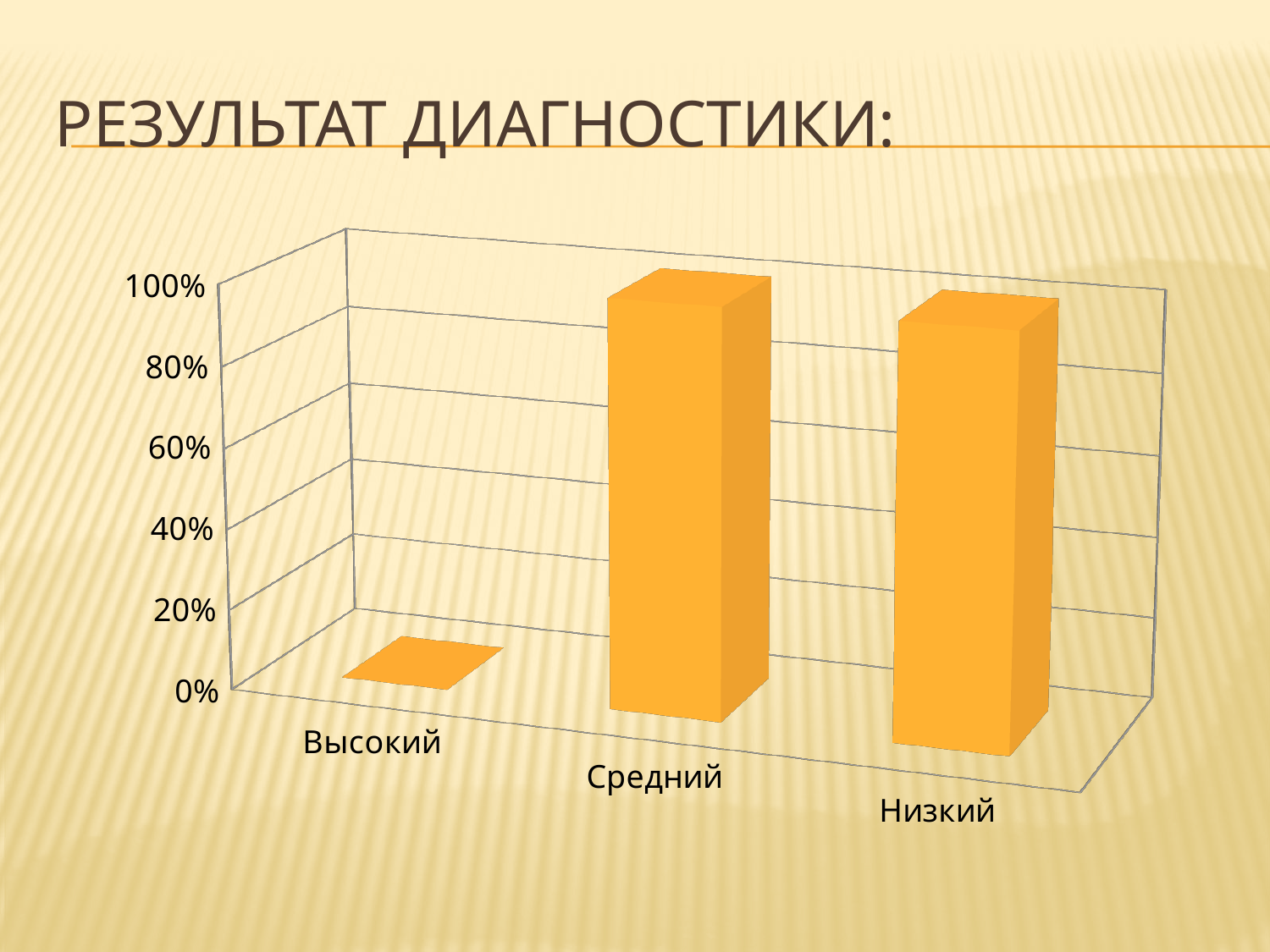
Is the value for Низкий greater or less than 60%? greater How many categories are shown on the x axis of the chart? 3 Is the value for Высокий greater or less than 20%? less What kind of chart is shown on the slide? bar chart What is the value for Высокий in the chart? 0% What is the title of the slide containing the chart? РЕЗУЛЬТАТ ДИАГНОСТИКИ: Is the value for Средний greater or less than 60%? greater Which category has the lowest value in the chart? Высокий What colour are the bars in the chart? orange Which is larger, the value for Высокий or the value for Низкий? Низкий